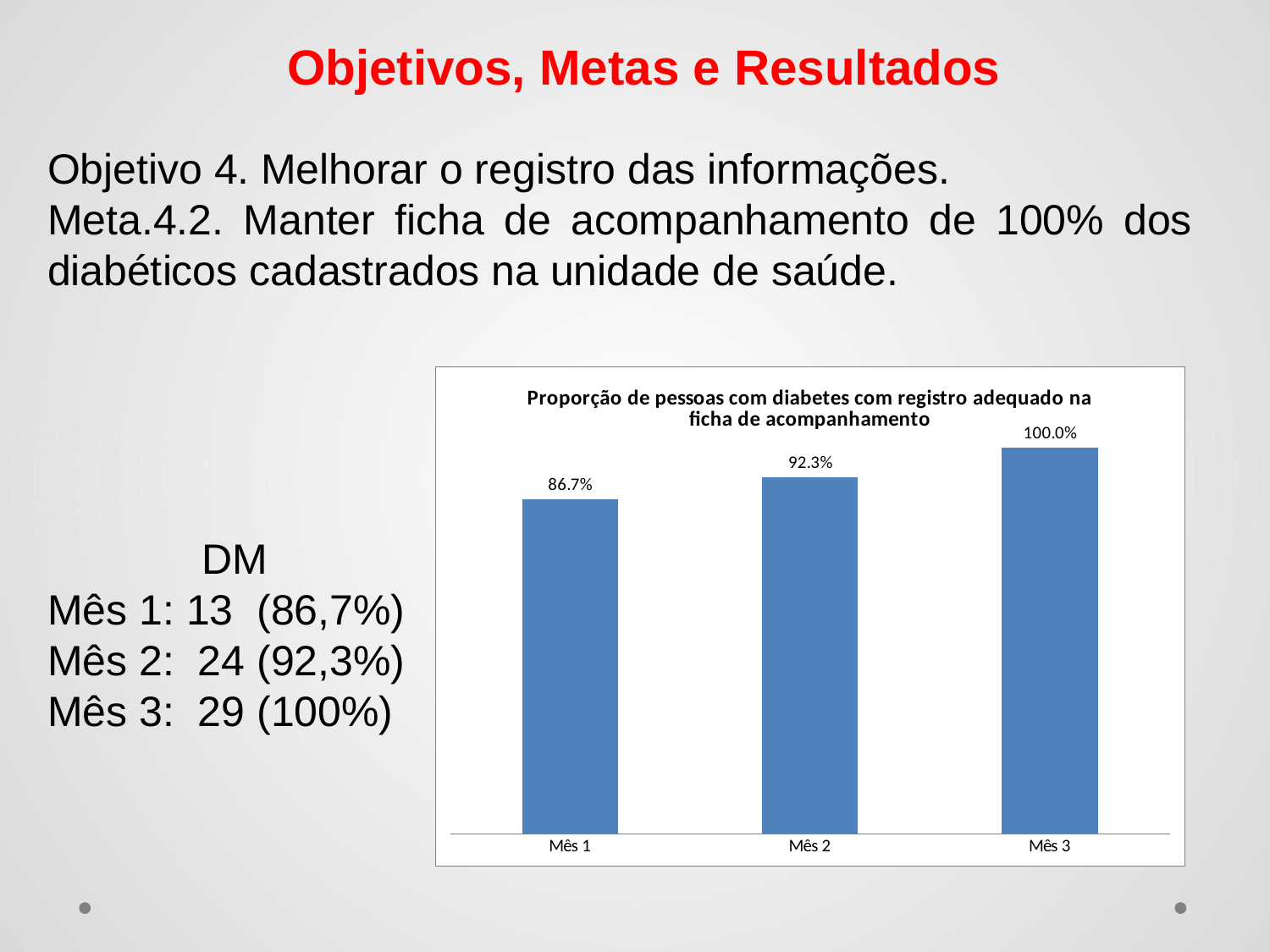
Which month has the highest value in the chart? Mês 3 What is the value for Mês 3 in the chart? 100.0% Do the values rise or fall from Mês 1 to Mês 3? Rise What kind of chart is shown on the slide? Bar chart What is the title of the chart? Proporção de pessoas com diabetes com registro adequado na ficha de acompanhamento What is the difference between the values for Mês 2 and Mês 1? 5.6% What is the value for Mês 1 in the chart? 86.7% How many bars are shown in the chart? 3 What is the difference between the values for Mês 3 and Mês 1? 13.3% What is the value for Mês 2 in the chart? 92.3% Which is larger, the value for Mês 2 or the value for Mês 1? Mês 2 Which month has the lowest value in the chart? Mês 1